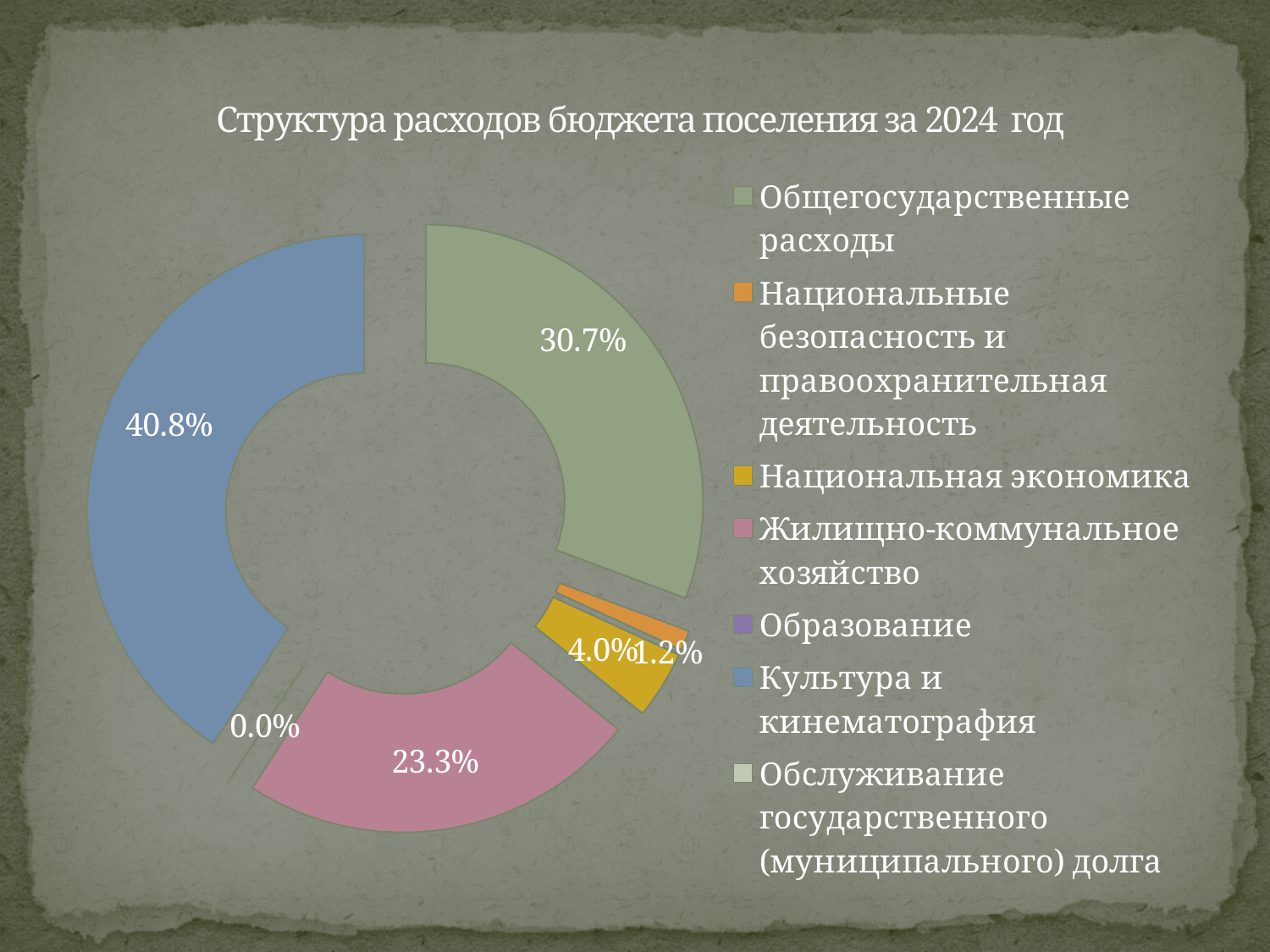
What percentage is shown for Общегосударственные расходы? 30.7% Which expenditure category has the largest share of the budget? Культура и кинематография What is the title of the chart? Структура расходов бюджета поселения за 2024 год What is the difference between the shares of Общегосударственные расходы and Жилищно-коммунальное хозяйство? 7.4% How many categories does the legend list? 7 What percentage is labelled for Национальная экономика? 4.0% What is the share of Жилищно-коммунальное хозяйство? 23.3% By how many percentage points does Культура и кинематография exceed Общегосударственные расходы? 10.1% What share of the budget expenditures goes to Культура и кинематография? 40.8% Which is larger: the share of Национальная экономика or the share of Национальные безопасность и правоохранительная деятельность? Национальная экономика What type of chart is shown on the slide? Doughnut (pie) chart What share is shown for Национальные безопасность и правоохранительная деятельность? 1.2%